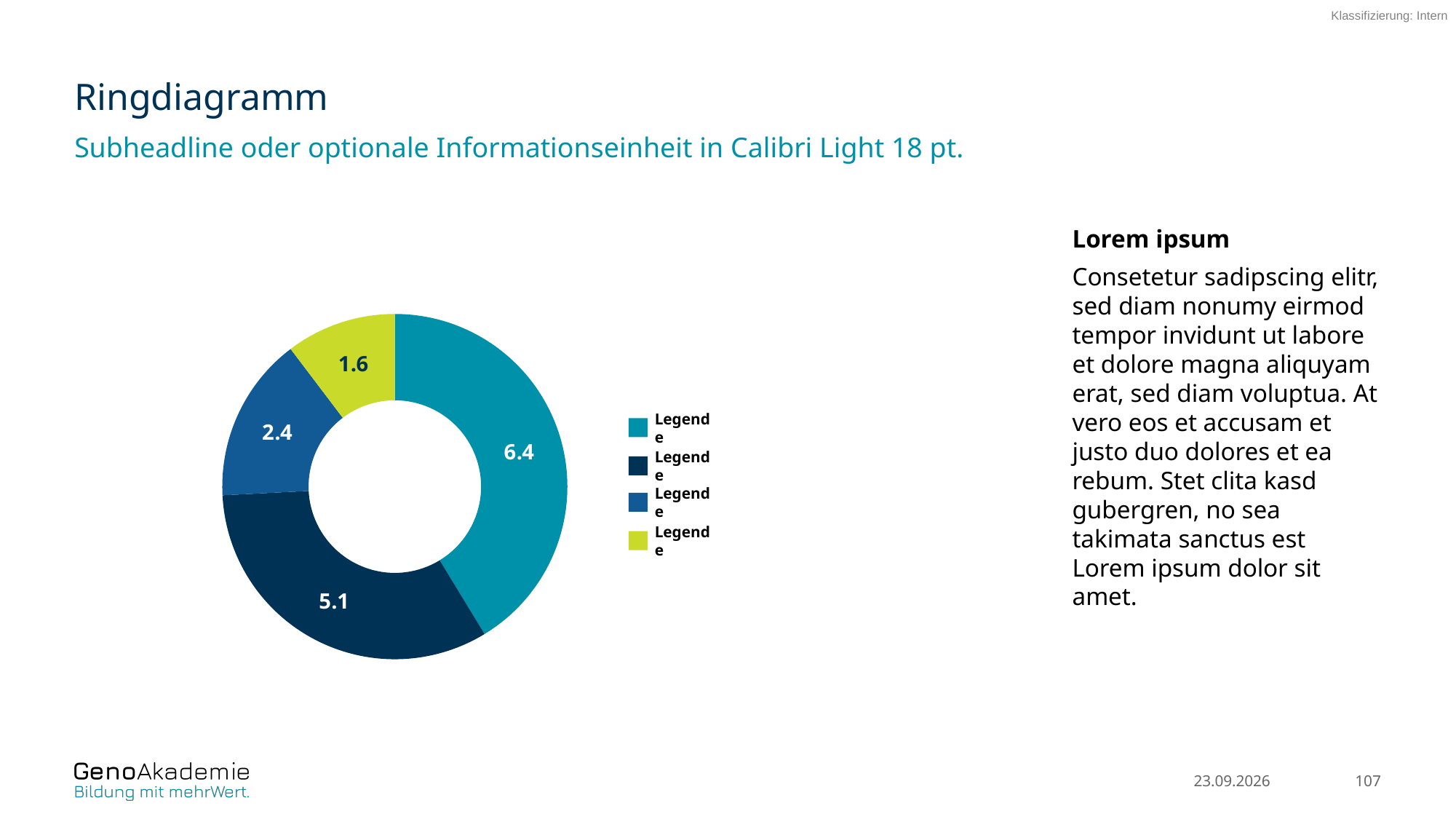
What is the total of all four slice values in the doughnut chart? 15.5 How many entries does the legend list? 4 What is the value of the teal (light blue) slice? 6.4 Which slice is larger, the medium blue slice or the lime green slice? the medium blue slice (2.4) What is the value of the lime green slice? 1.6 What kind of chart is shown on the slide? doughnut chart How many slices does the doughnut chart have? 4 What is the difference between the teal slice (6.4) and the dark navy slice (5.1)? 1.3 What is the largest value shown in the doughnut chart? 6.4 What is the smallest value shown in the doughnut chart? 1.6 What is the value of the dark navy slice? 5.1 What is the value of the medium blue slice? 2.4